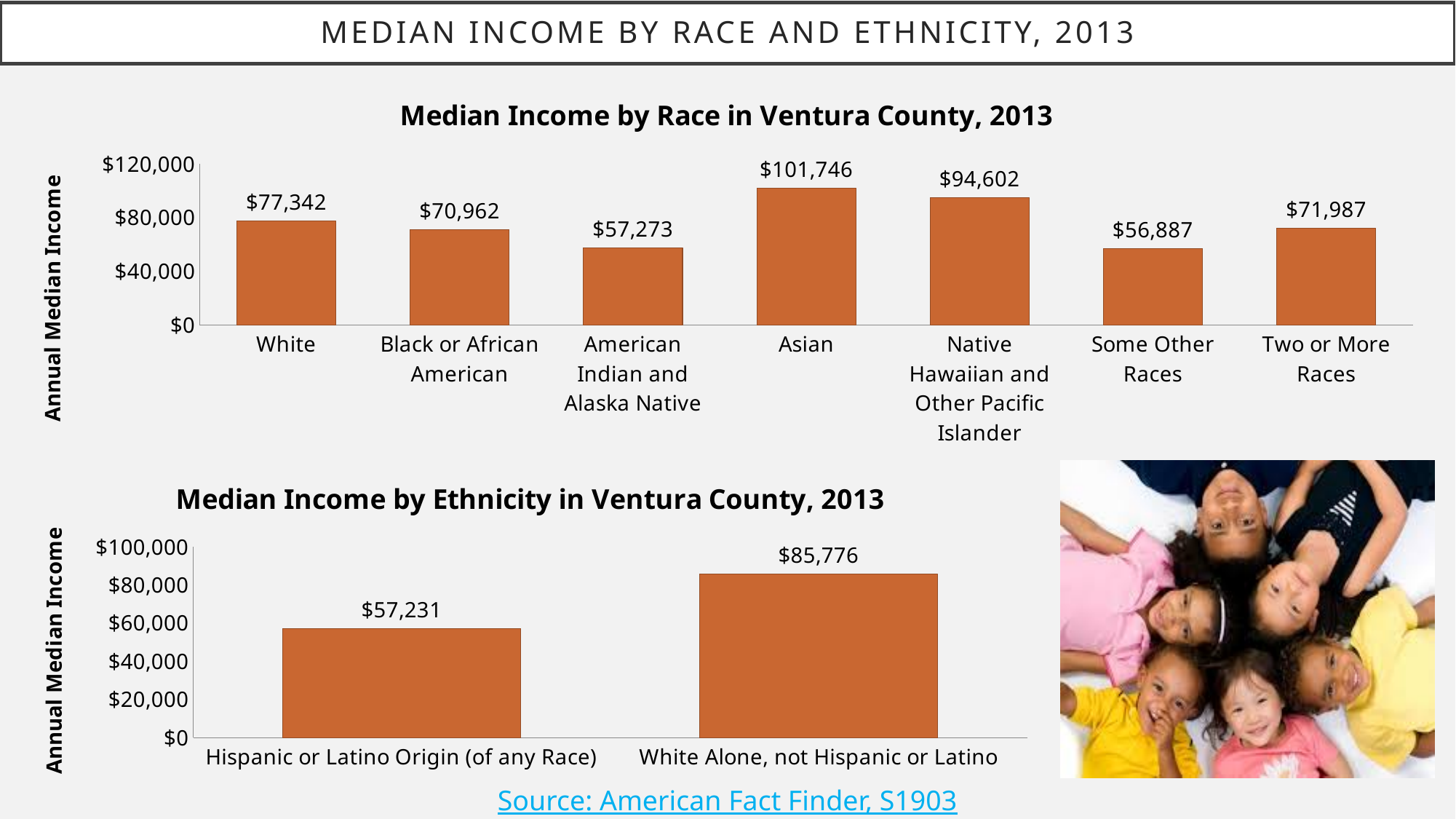
What kind of chart is the 'Median Income by Ethnicity in Ventura County, 2013' chart? Bar chart In the 'Median Income by Race in Ventura County, 2013' chart, is the value for Native Hawaiian and Other Pacific Islander greater or less than $80,000? greater In the 'Median Income by Ethnicity in Ventura County, 2013' chart, what is the difference between the median income for White Alone, not Hispanic or Latino and for Hispanic or Latino Origin (of any Race)? $28,545 In the 'Median Income by Race in Ventura County, 2013' chart, how many race categories are shown? 7 In the 'Median Income by Race in Ventura County, 2013' chart, which race has the lowest median income? Some Other Races In the 'Median Income by Ethnicity in Ventura County, 2013' chart, what is the median income for Hispanic or Latino Origin (of any Race)? $57,231 What is the y-axis label on the 'Median Income by Race in Ventura County, 2013' chart? Annual Median Income In the 'Median Income by Race in Ventura County, 2013' chart, what is the median income for Asian? $101,746 In the 'Median Income by Race in Ventura County, 2013' chart, which race has the highest median income? Asian In the 'Median Income by Race in Ventura County, 2013' chart, what is the difference between the median income for Asian and for White? $24,404 In the 'Median Income by Race in Ventura County, 2013' chart, which is larger: the median income for Black or African American or for Two or More Races? Two or More Races In the 'Median Income by Race in Ventura County, 2013' chart, what is the median income for Some Other Races? $56,887